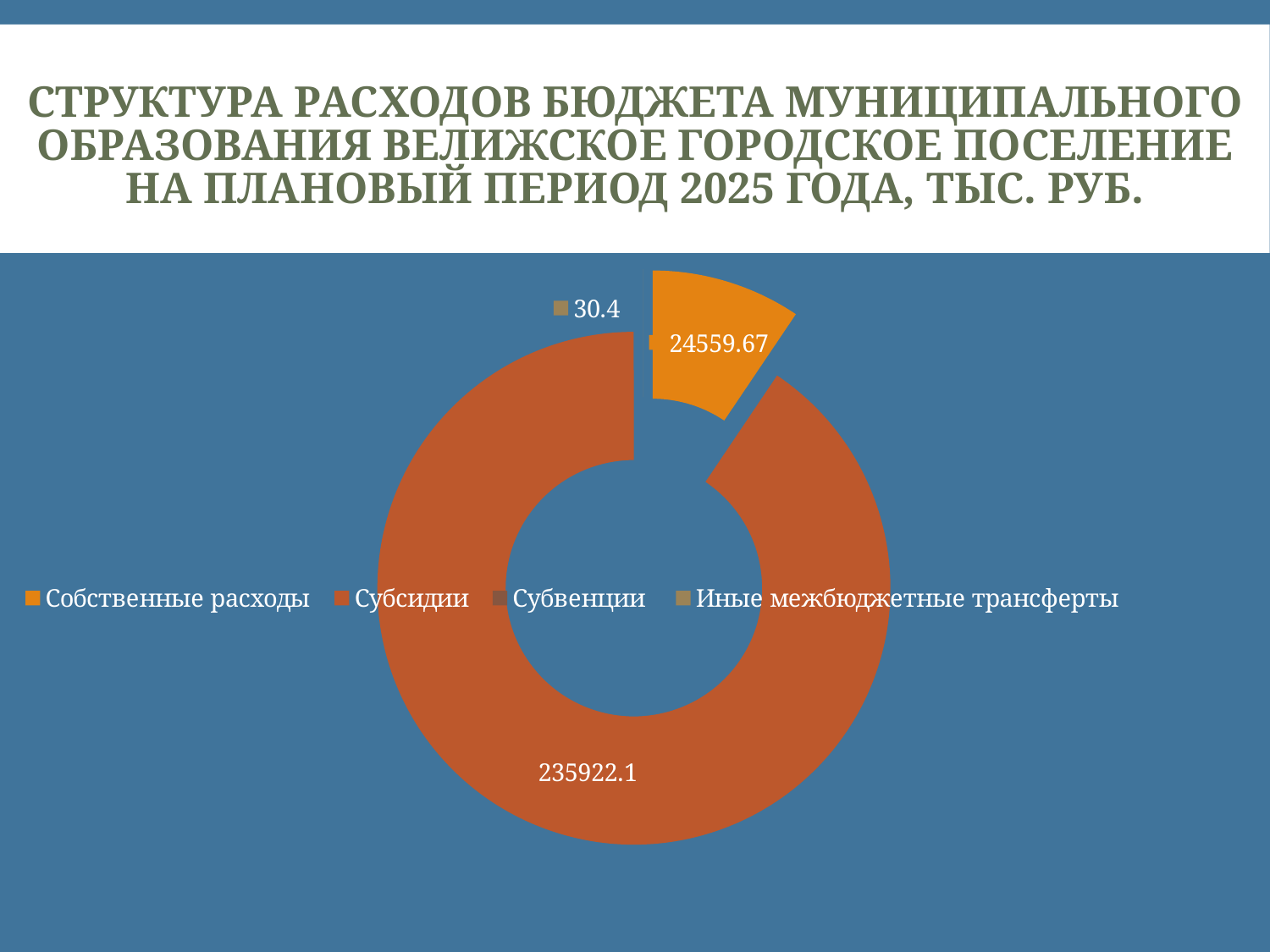
Which is larger, Собственные расходы or Иные межбюджетные трансферты? Собственные расходы What value is shown for Собственные расходы? 24559.67 Which category has the largest value in the chart? Субсидии Which labelled category has the smallest value in the chart? Иные межбюджетные трансферты What is the difference between the values for Субсидии and Собственные расходы? 211362.43 How many entries does the legend list? 4 What value is shown for Субсидии? 235922.1 Which is larger, Собственные расходы or Субсидии? Субсидии Which legend entry is shown in the lighter orange colour? Собственные расходы What value is shown for Иные межбюджетные трансферты? 30.4 What kind of chart is shown on the slide? Doughnut (pie) chart In what units are the values on the slide given, according to the title? тыс. руб.